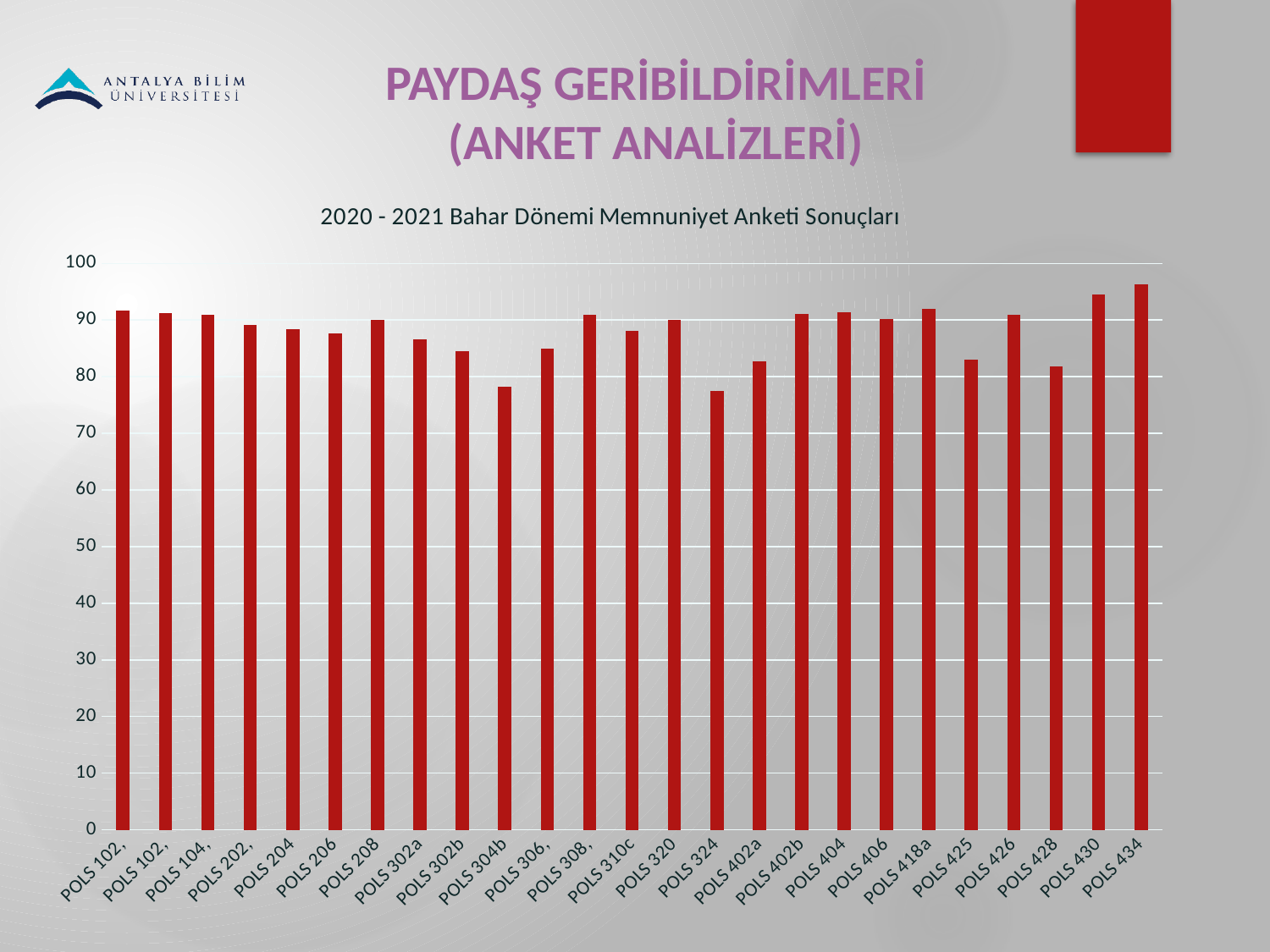
Is the value for POLS 206 greater or less than 90? less Is the value for POLS 324 greater or less than 80? less Which is larger, the value for POLS 434 or the value for POLS 324? POLS 434 Is the value for POLS 425 greater or less than 80? greater What colour are the bars in the chart? red Which course has the highest bar? POLS 434 Which is larger, the value for POLS 304b or the value for POLS 308? POLS 308 What kind of chart is shown on the slide? bar chart How many course categories are plotted on the x axis? 25 What is the title of the chart? 2020 - 2021 Bahar Dönemi Memnuniyet Anketi Sonuçları